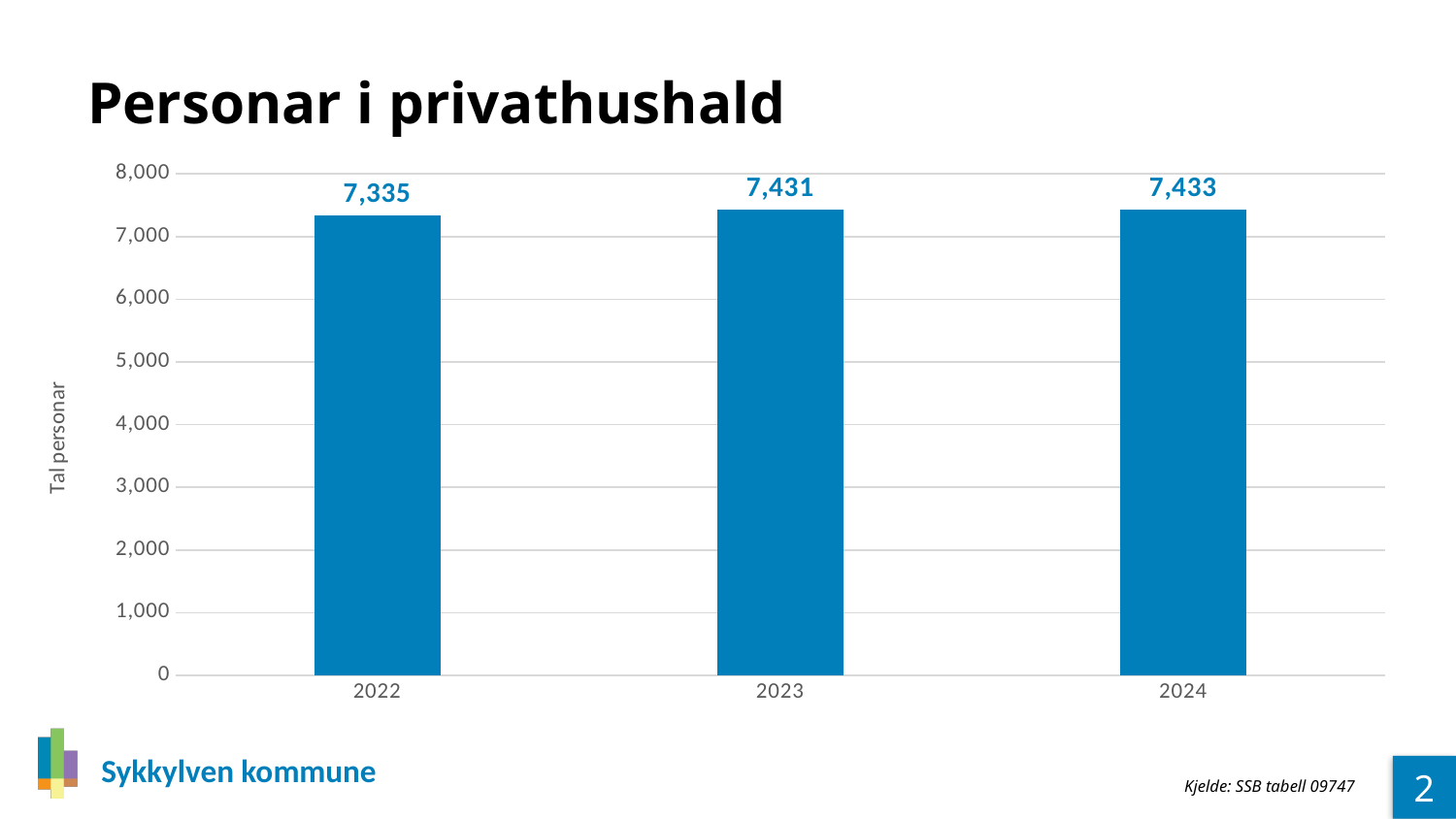
Which is larger, the value for 2022 or the value for 2023? 2023 What kind of chart is shown on the slide? bar chart What is the difference between the values for 2024 and 2022? 98 Is the value for 2022 greater or less than 7,000? greater What is the title of the chart? Personar i privathushald What is the difference between the values for 2024 and 2023? 2 What is the value for 2024? 7,433 What is the value for 2022? 7,335 What is the difference between the values for 2023 and 2022? 96 Which year has the lowest value? 2022 How many years are shown on the x axis? 3 What is the value for 2023? 7,431